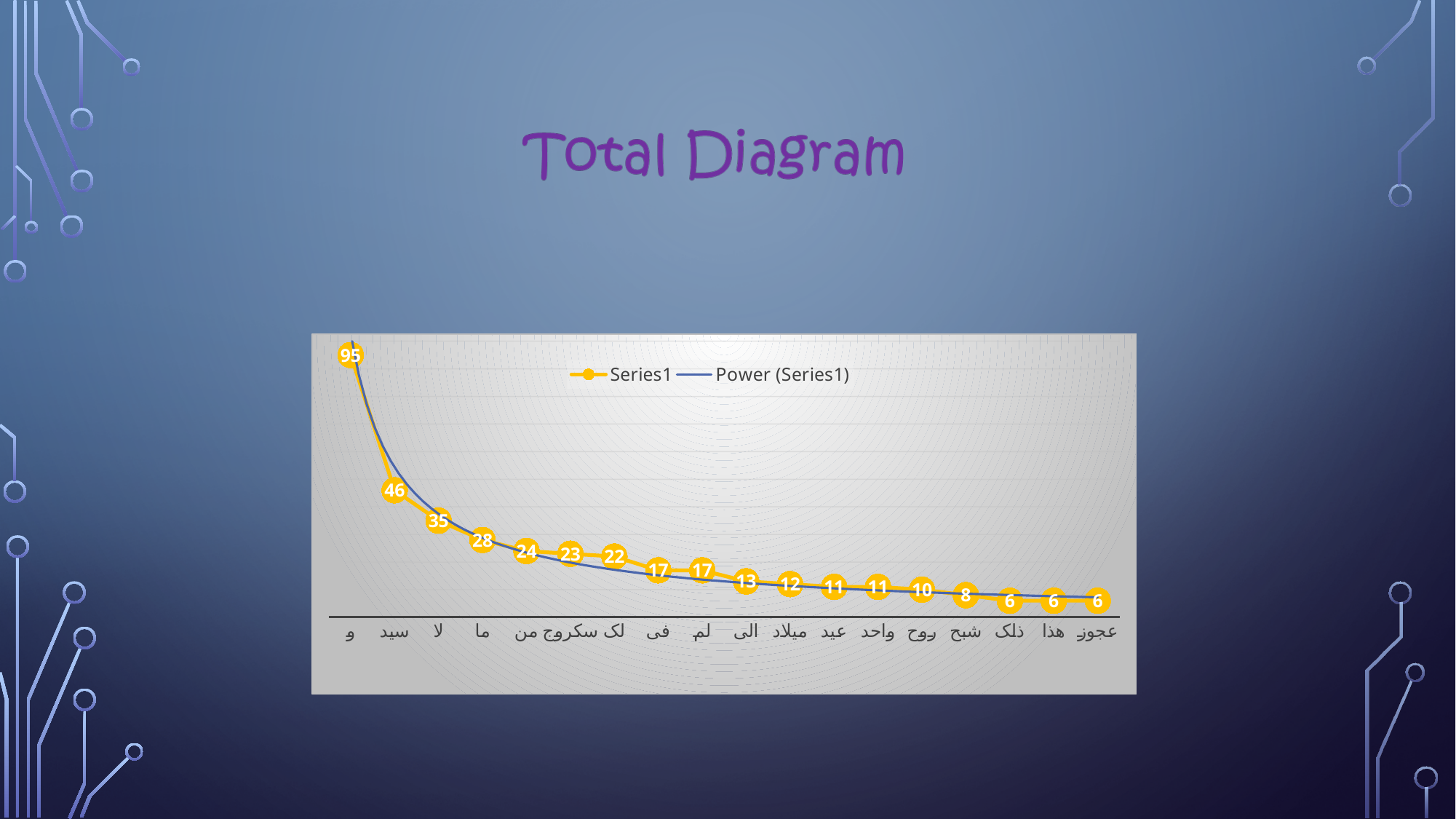
Which category has the highest value? و What is the value for the category لا? 35 What is the value for the category و? 95 Do the values rise or fall from left to right along the x axis? fall What kind of chart is shown on the slide? line chart What is the value for the category سيد? 46 What is the value for the category روح? 10 How many entries does the legend list? 2 What is the value for the category ما? 28 What is the difference between the values for و and سيد? 49 Which has a larger value, سيد or لا? سيد How many data points are plotted on the chart? 18